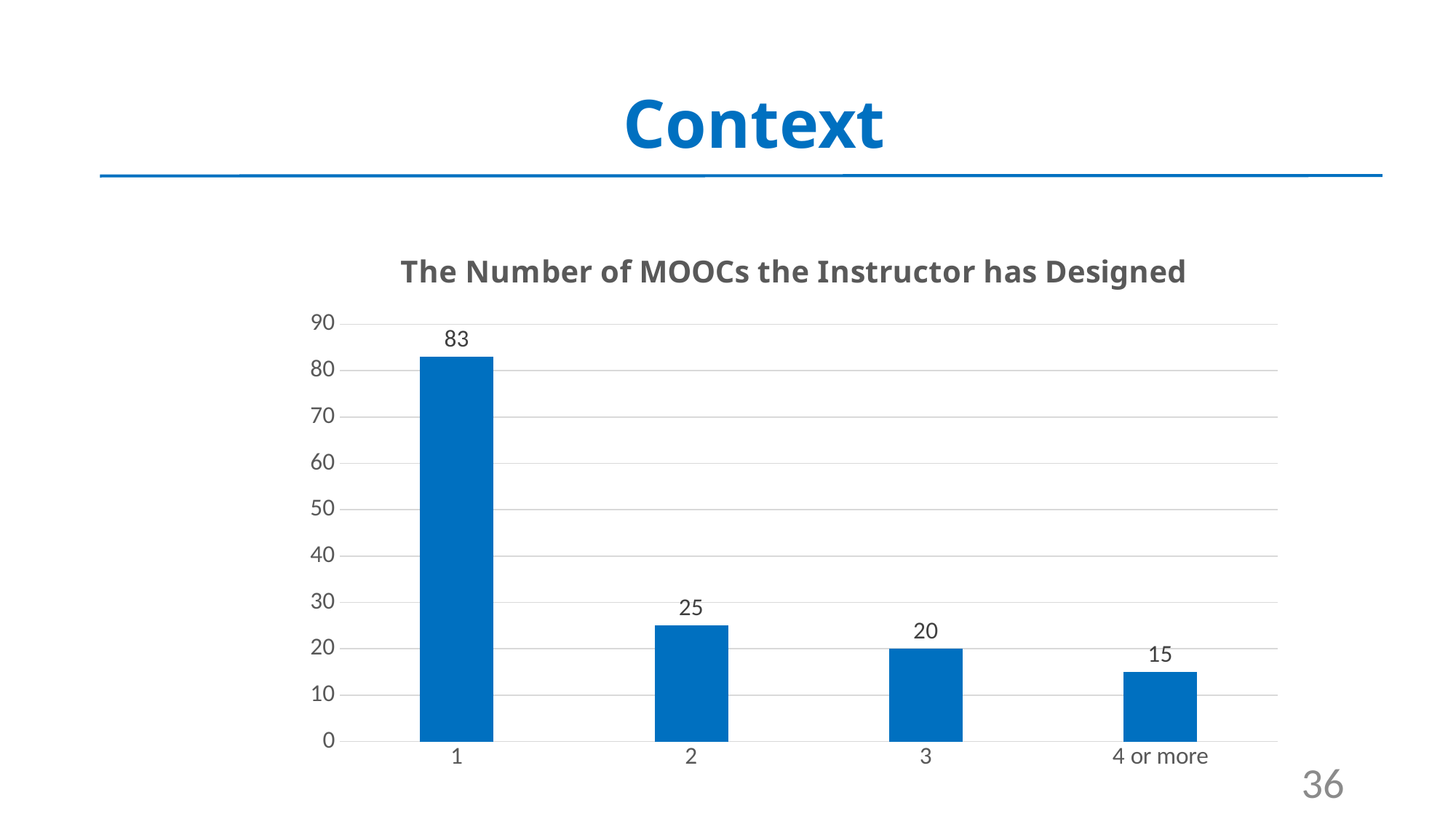
What is the title of the chart? The Number of MOOCs the Instructor has Designed Is the value for "1" greater or less than 80? greater What kind of chart is shown on the slide? bar chart What is the value for the category "1"? 83 What is the value for the category "4 or more"? 15 What is the difference between the values for "3" and "4 or more"? 5 What is the difference between the values for "1" and "2"? 58 Which is larger, the value for "2" or the value for "3"? 2 What is the value for the category "3"? 20 Which category has the lowest value? 4 or more How many categories are shown on the x axis? 4 Which category has the highest value? 1